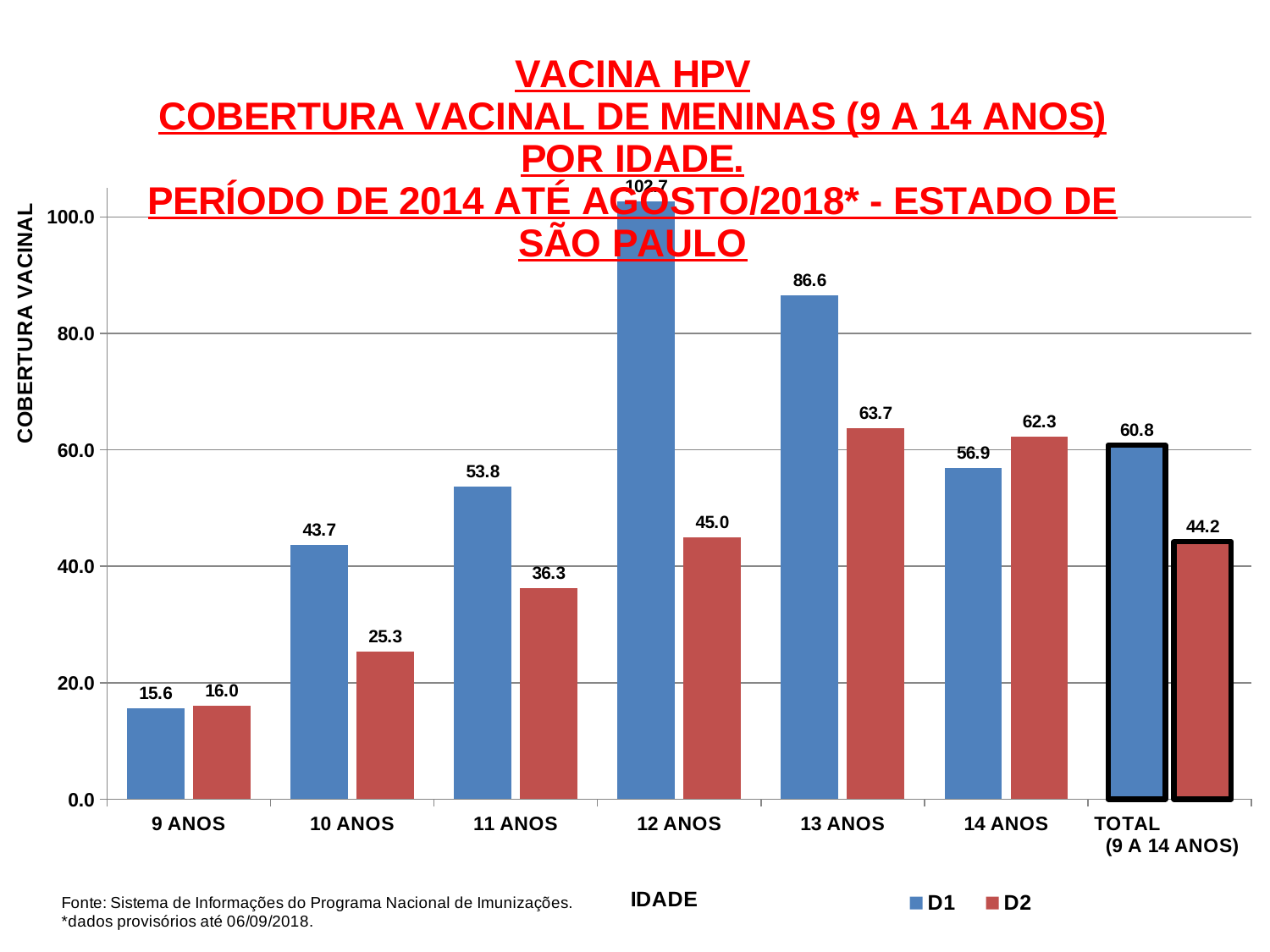
How many series does the legend list? 2 Which age category has the lowest D2 value? 9 ANOS What is the D2 value for 10 ANOS? 25.3 What kind of chart is shown on the slide? bar chart Which age category has the highest D1 value? 12 ANOS How many categories are shown on the x axis? 7 What is the D1 value for 13 ANOS? 86.6 What is the D2 value for 14 ANOS? 62.3 Is the D2 value for 13 ANOS greater or less than 60.0? greater What is the D1 value for TOTAL (9 A 14 ANOS)? 60.8 What is the difference between the D1 and D2 values for 11 ANOS? 17.5 For 14 ANOS, which is larger, D1 or D2? D2